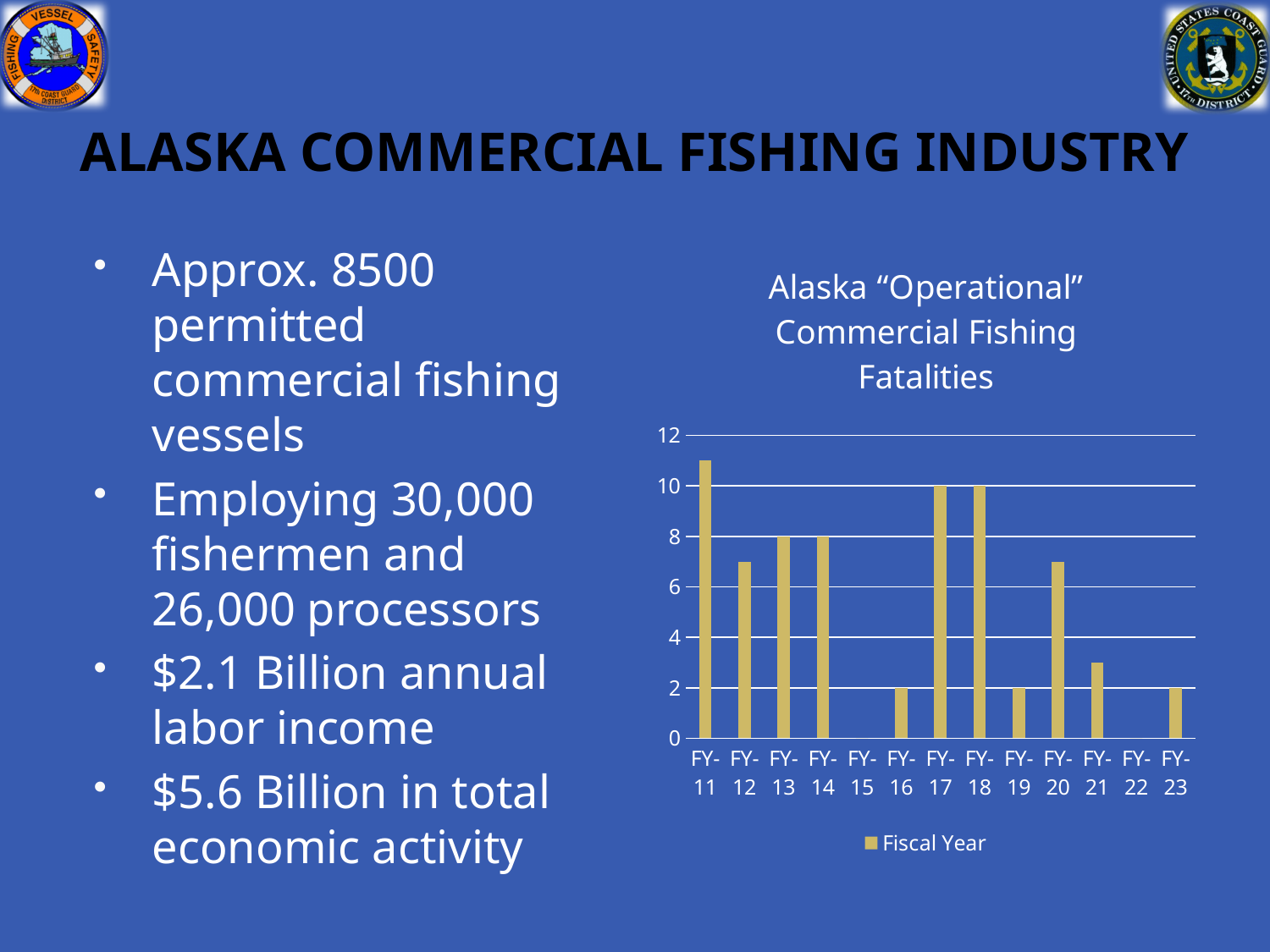
What is the legend entry shown below the chart? Fiscal Year What is the title of the chart on the slide? Alaska "Operational" Commercial Fishing Fatalities Which fiscal year has the highest number of fatalities in the chart? FY-11 How many fatalities are shown for FY-16? 2 How many fatalities are shown for FY-17? 10 How many series does the chart legend list? 1 What is the difference between the fatalities in FY-17 and FY-16? 8 Which fiscal year has more fatalities, FY-12 or FY-21? FY-12 Is the value for FY-11 greater or less than 10? greater How many fatalities are shown for FY-13? 8 What type of chart is shown on the slide? Bar chart How many fiscal years are shown on the x axis of the chart? 13